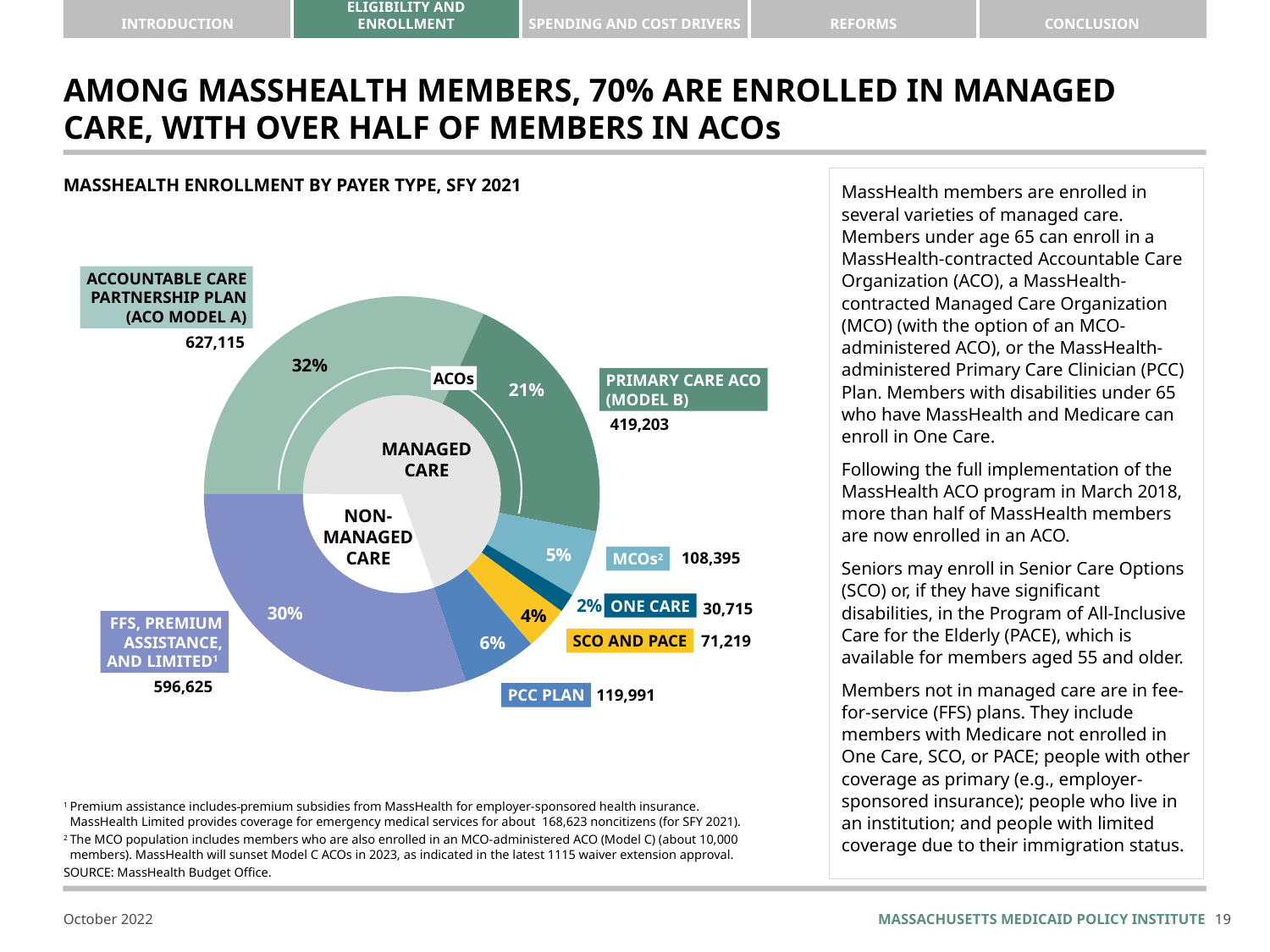
What is the enrollment for the Accountable Care Partnership Plan (ACO Model A)? 627,115 What is the enrollment for the PCC Plan? 119,991 How many payer type segments are shown in the chart? 7 Which payer type has the smallest enrollment? One Care Which payer type has the largest enrollment? Accountable Care Partnership Plan (ACO Model A) What is the enrollment for the Primary Care ACO (Model B)? 419,203 Which has higher enrollment, the PCC Plan or MCOs? PCC Plan What share of MassHealth enrollment is in MCOs? 5% What is the title of the chart? MassHealth Enrollment by Payer Type, SFY 2021 What kind of chart is shown on the slide? Doughnut chart What share of MassHealth enrollment is in FFS, Premium Assistance, and Limited? 30% What is the difference in enrollment between SCO and PACE and One Care? 40,504